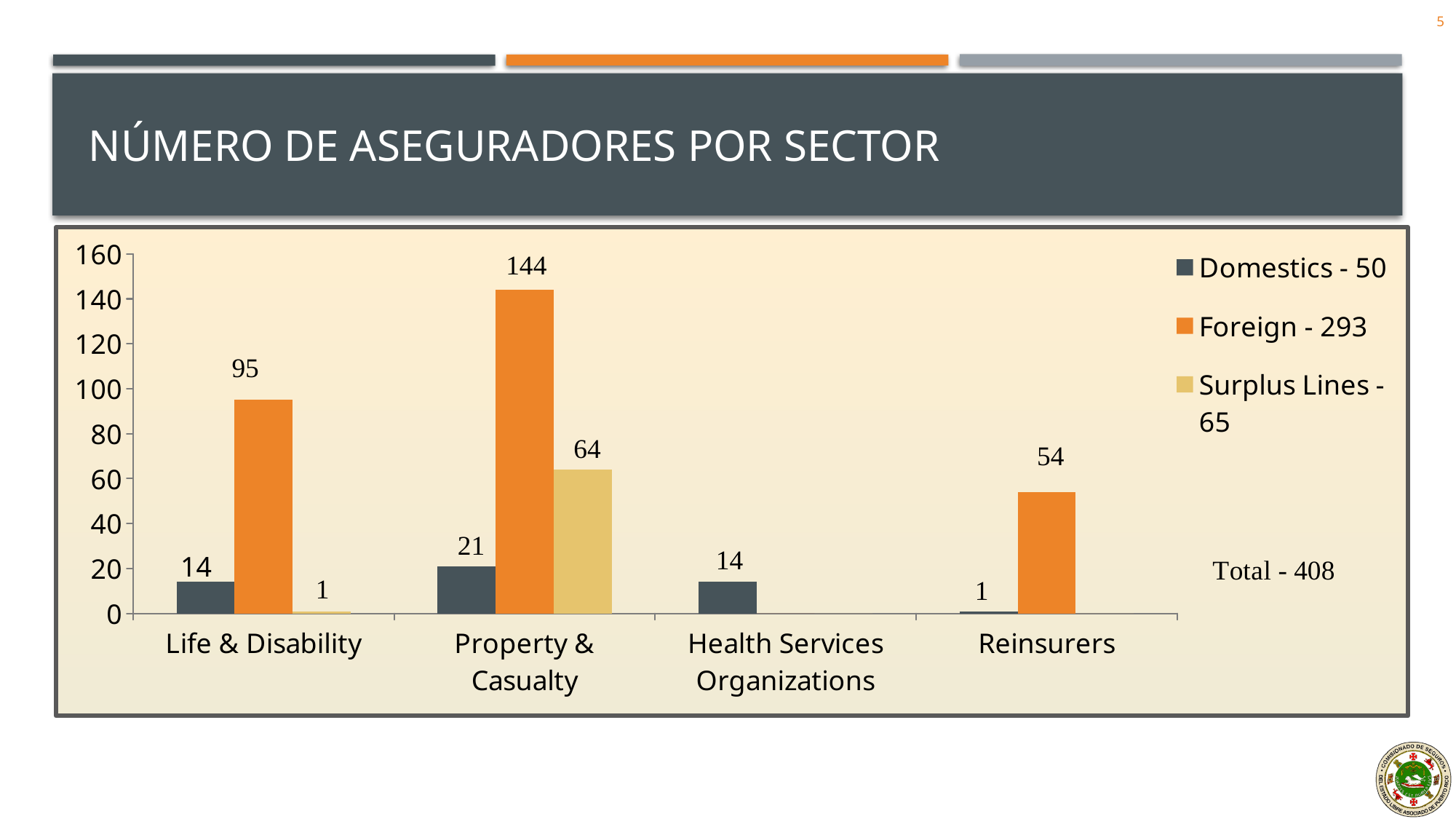
What is the Domestics value for Life & Disability? 14 What total is printed on the chart? Total - 408 How many series does the legend list? 3 Which category has the highest Foreign value? Property & Casualty How many categories are shown on the x axis? 4 Which is larger: the Domestics value for Property & Casualty or the Domestics value for Health Services Organizations? Property & Casualty What is the Foreign value for Property & Casualty? 144 What is the difference between the Foreign values for Property & Casualty and Life & Disability? 49 What is the Surplus Lines value for Property & Casualty? 64 What kind of chart is shown on the slide? Bar chart Which category has the lowest Domestics value? Reinsurers What is the Foreign value for Reinsurers? 54